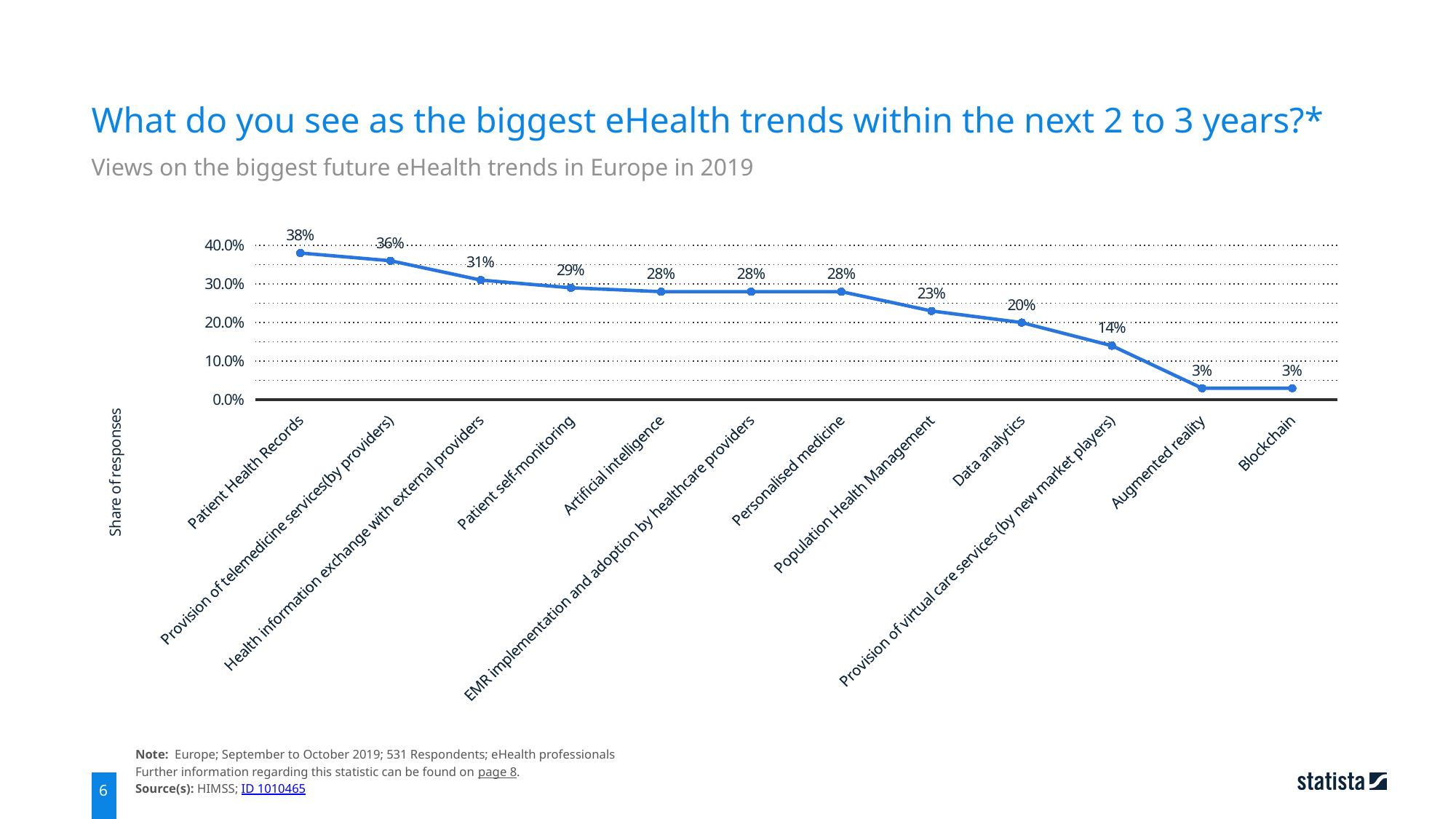
What kind of chart is shown on the slide? Line chart Which category has the highest value? Patient Health Records Do the values rise or fall from left to right along the x axis? Fall What is the label of the vertical axis? Share of responses What is the difference between the values for Patient Health Records and Blockchain? 35% Which is larger, the value for Patient self-monitoring or the value for Data analytics? Patient self-monitoring What is the value for Patient Health Records? 38% What is the value for Health information exchange with external providers? 31% What is the value for Provision of virtual care services (by new market players)? 14% What is the difference between the values for Provision of telemedicine services(by providers) and Population Health Management? 13% How many categories are plotted on the chart? 12 What is the value for Data analytics? 20%